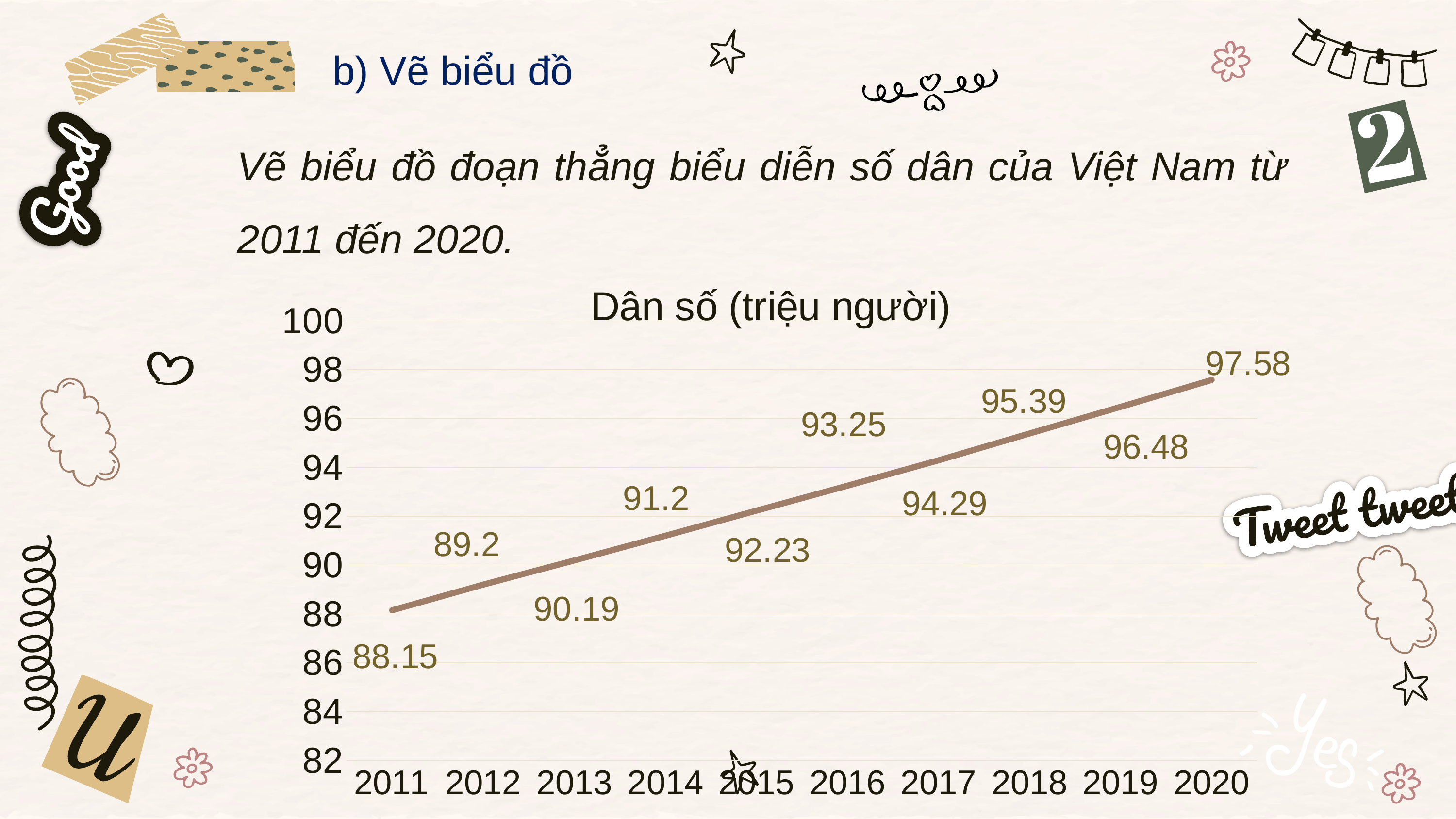
How many years are plotted on the x axis? 10 What type of chart is shown on the slide? Line chart What is the value for 2011? 88.15 What is the difference between the values for 2020 and 2011? 9.43 Do the values rise or fall from 2011 to 2020? Rise Which year has the lowest value? 2011 Which is larger, the value for 2017 or the value for 2014? 2017 Which year has the highest value? 2020 What is the title of the chart? Dân số (triệu người) What is the value for 2015? 92.23 What is the value for 2020? 97.58 Is the value for 2018 greater or less than 94? greater